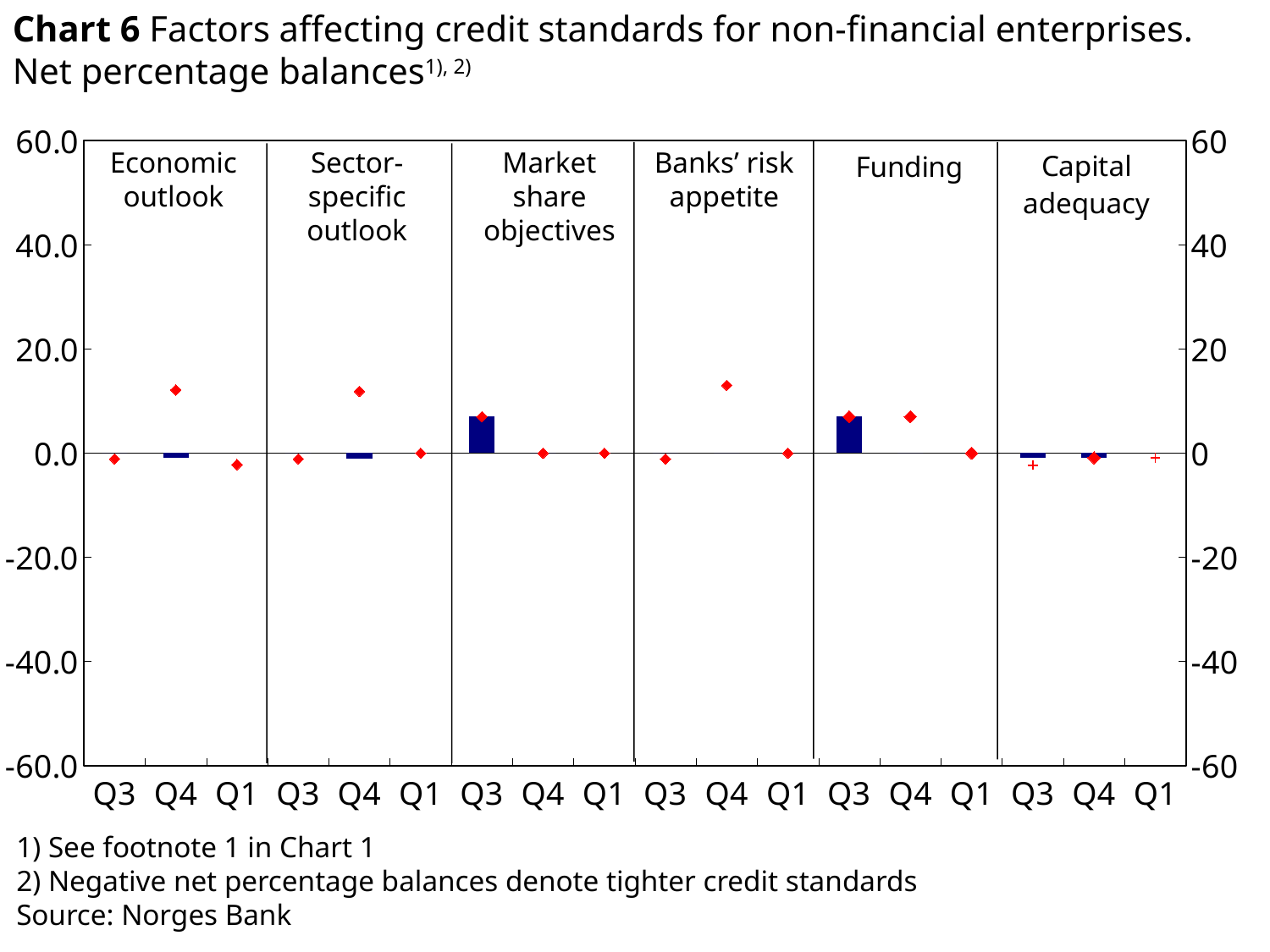
How many quarters are shown for each factor? 3 Which is larger, the Q3 bar for Market share objectives or the Q3 bar for Economic outlook? Market share objectives Is the Q3 bar for Funding greater or less than 20? less Is the Q4 red marker for Economic outlook greater or less than 0? greater What is the title of the chart? Chart 6 Factors affecting credit standards for non-financial enterprises. Net percentage balances How many factors (panels) are shown in the chart? 6 What kind of chart is shown on the slide? bar chart How many quarter labels appear along the x axis in total? 18 Is the Q4 red marker for Banks' risk appetite greater or less than 20? less What is the source given for the chart? Norges Bank